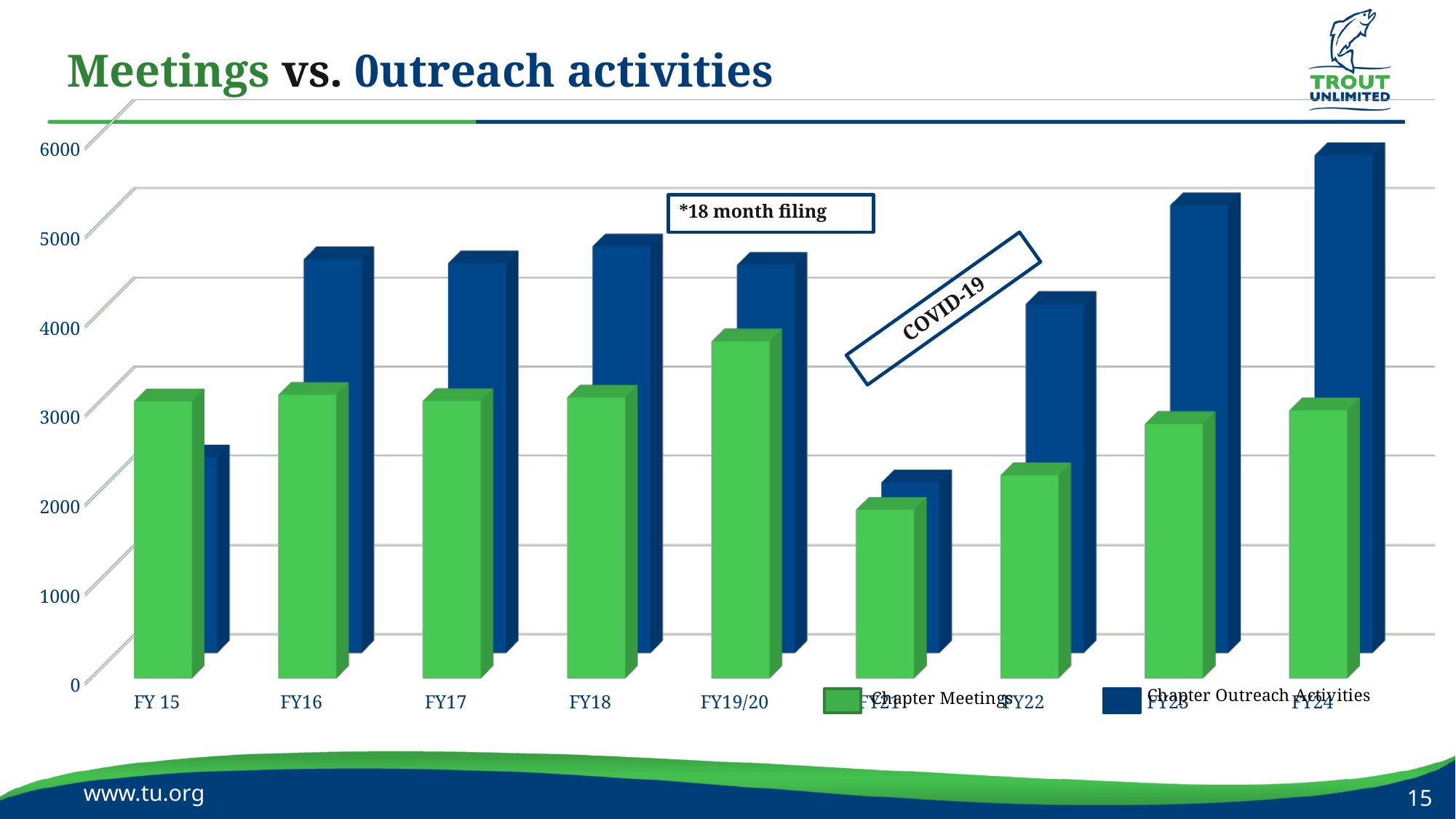
Do the Chapter Outreach Activities values rise or fall from FY21 to FY24? rise How many series does the legend list? 2 Is the value for Chapter Outreach Activities in FY24 greater or less than 5000? greater How many fiscal year categories are shown on the x axis? 9 Is the value for Chapter Outreach Activities in FY 15 greater or less than 3000? less What annotation is placed on the chart between the FY19/20 and FY22 bars? COVID-19 In FY24, which is larger: Chapter Meetings or Chapter Outreach Activities? Chapter Outreach Activities Which fiscal year has the lowest value for Chapter Meetings? FY21 Which fiscal year has the highest value for Chapter Meetings? FY19/20 Which fiscal year has the highest value for Chapter Outreach Activities? FY24 What kind of chart is shown on the slide? bar chart In FY 15, which is larger: Chapter Meetings or Chapter Outreach Activities? Chapter Meetings